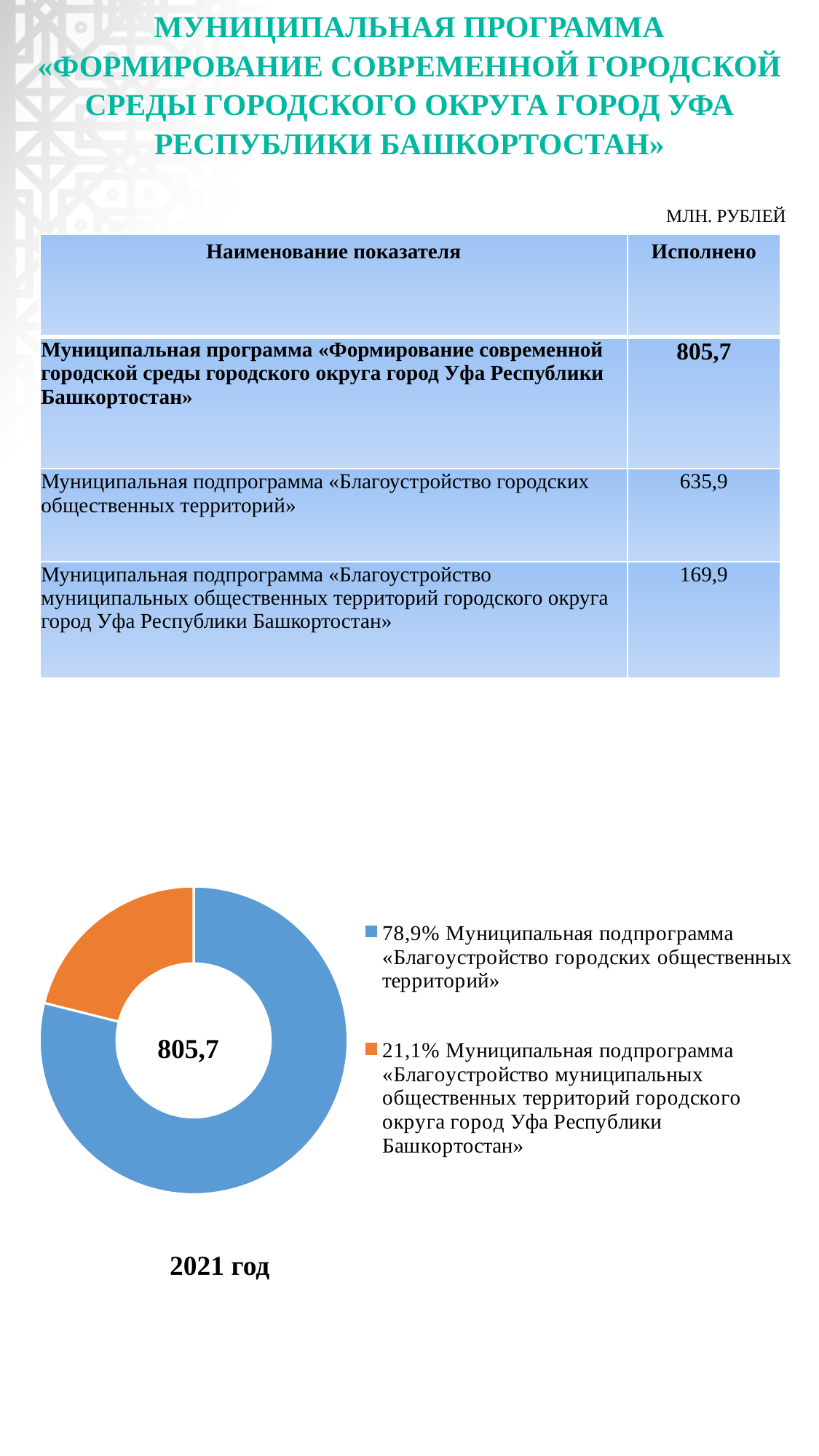
Which slice of the doughnut chart is the largest? Муниципальная подпрограмма «Благоустройство городских общественных территорий» (78,9%) What kind of chart is shown at the bottom of the slide? Doughnut (pie) chart How many slices does the doughnut chart have? 2 Which is larger in the doughnut chart: the share of «Благоустройство городских общественных территорий» or the share of «Благоустройство муниципальных общественных территорий»? «Благоустройство городских общественных территорий» What share of the doughnut chart does the subprogramme «Благоустройство муниципальных общественных территорий городского округа город Уфа Республики Башкортостан» take? 21,1% What colour is the slice for «Благоустройство городских общественных территорий» in the doughnut chart? Blue By how many percentage points does the larger slice of the doughnut chart exceed the smaller one? 57,8 How many entries does the legend of the doughnut chart list? 2 Which year is labelled under the doughnut chart? 2021 год What value is printed in the centre of the doughnut chart? 805,7 Which slice of the doughnut chart is the smallest? Муниципальная подпрограмма «Благоустройство муниципальных общественных территорий городского округа город Уфа Республики Башкортостан» (21,1%) What share of the doughnut chart does the subprogramme «Благоустройство городских общественных территорий» take? 78,9%